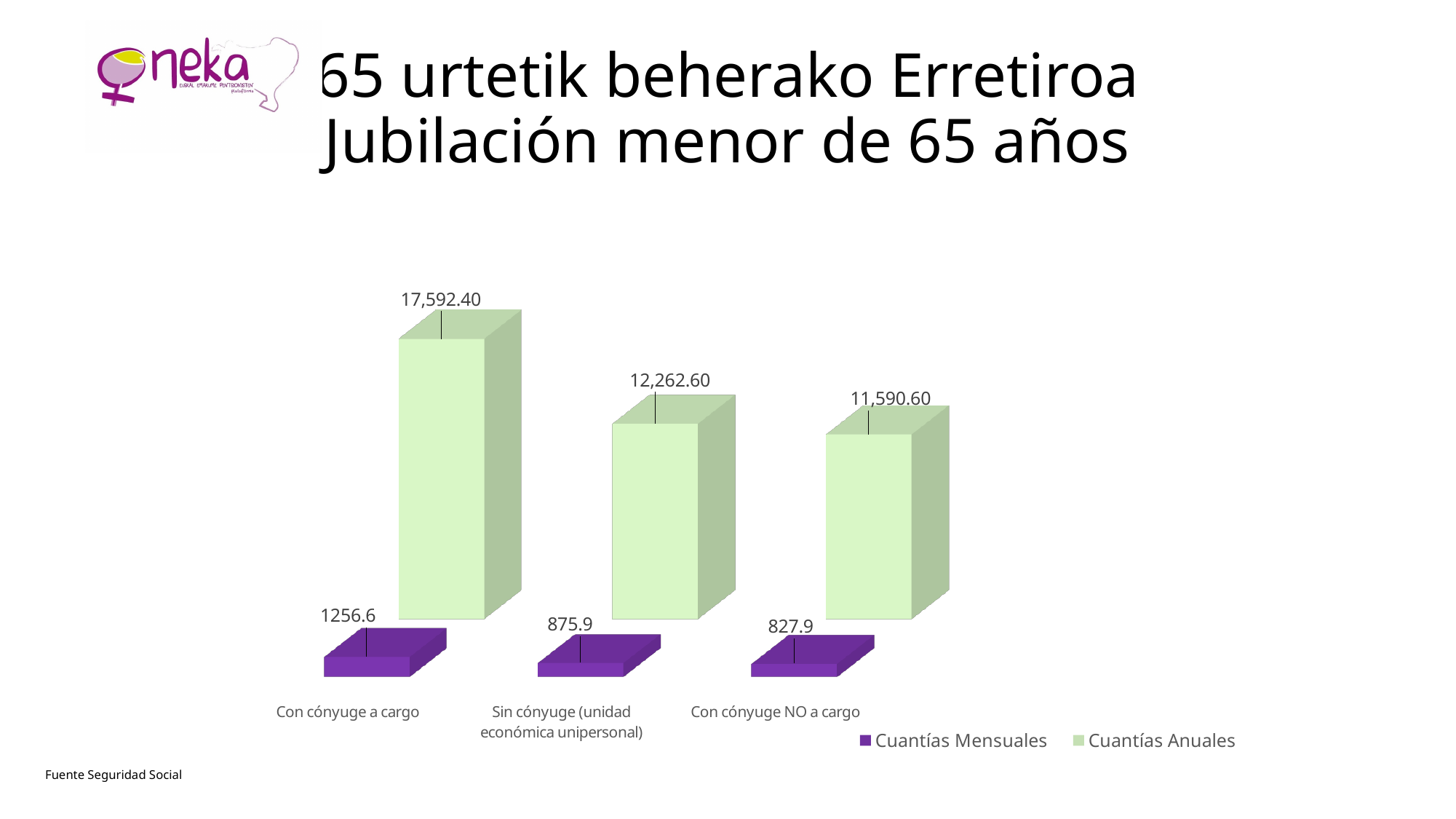
Which category has the lowest Cuantías Mensuales value? Con cónyuge NO a cargo How many categories are shown on the x axis? 3 What is the difference between the Cuantías Anuales values for Con cónyuge a cargo and Sin cónyuge (unidad económica unipersonal)? 5,329.80 What kind of chart is shown on the slide? Bar chart What is the Cuantías Anuales value for Con cónyuge a cargo? 17,592.40 How many series does the legend list? 2 What is the Cuantías Mensuales value for Con cónyuge NO a cargo? 827.9 Which category has the highest Cuantías Anuales value? Con cónyuge a cargo What is the Cuantías Anuales value for Con cónyuge NO a cargo? 11,590.60 Do the Cuantías Anuales values rise or fall from left to right across the categories? Fall Which is larger: the Cuantías Mensuales value for Sin cónyuge (unidad económica unipersonal) or for Con cónyuge NO a cargo? Sin cónyuge (unidad económica unipersonal) What is the Cuantías Mensuales value for Sin cónyuge (unidad económica unipersonal)? 875.9